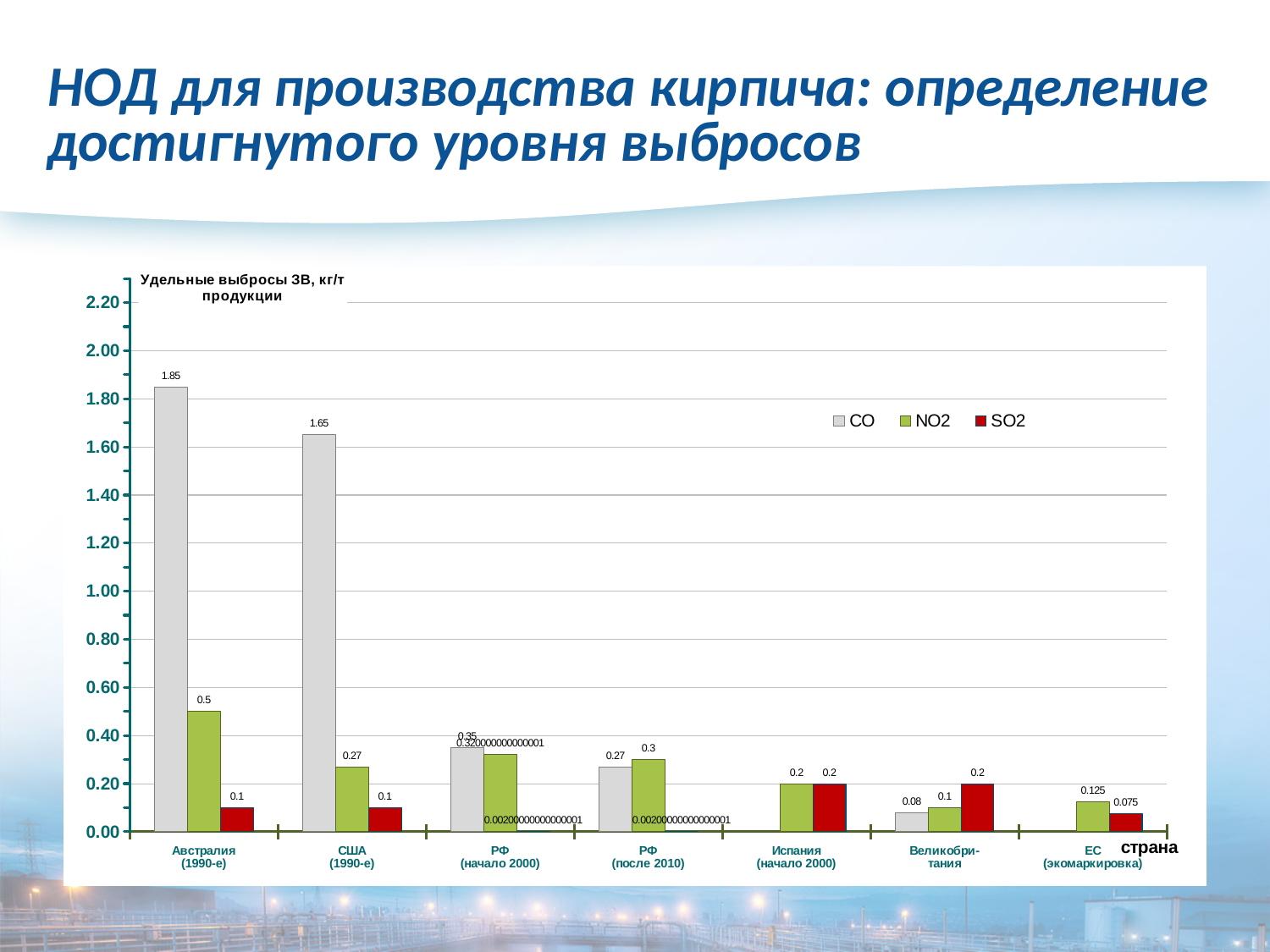
What is the difference between the CO values for Австралия (1990-е) and США (1990-е)? 0.2 Which is larger, the NO2 value for Австралия (1990-е) or the NO2 value for РФ (после 2010)? Австралия (1990-е) What is the NO2 value for США (1990-е)? 0.27 What kind of chart is shown on the slide? bar chart What is the SO2 value for Великобритания? 0.2 Which country has the highest CO value? Австралия (1990-е) How many series does the legend list? 3 What is the CO value for Австралия (1990-е)? 1.85 How many countries/categories are shown on the x axis? 7 What is the y-axis label of the chart? Удельные выбросы ЗВ, кг/т продукции Which country has the lowest NO2 value? Великобритания What is the NO2 value for ЕС (экомаркировка)? 0.125